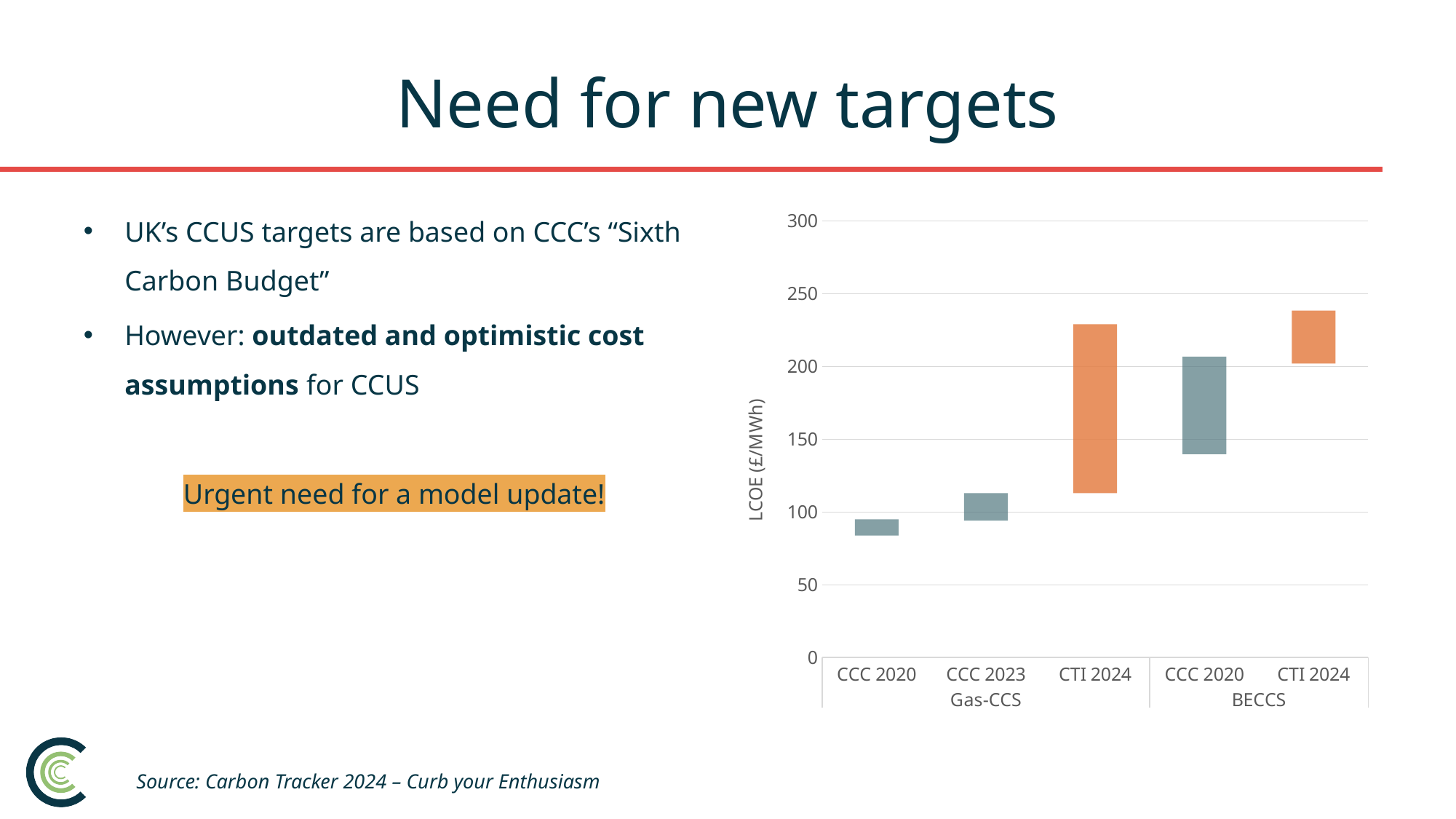
Which colour are the CTI 2024 bars in the chart? orange How many bars are plotted in the chart? 5 How many technology groups are shown on the x axis of the chart? 2 Is the upper end of the CCC 2020 Gas-CCS bar greater or less than 100? less What is the label of the y axis of the chart? LCOE (£/MWh) Is the upper end of the CTI 2024 Gas-CCS bar greater or less than 200? greater Which bar in the chart has the lowest values? CCC 2020 (Gas-CCS) Within the Gas-CCS group, do the LCOE ranges rise or fall from CCC 2020 to CTI 2024? rise What kind of chart is shown on the slide? bar chart Is the upper end of the CTI 2024 BECCS bar greater or less than 200? greater Within Gas-CCS, which bar reaches higher: CCC 2023 or CTI 2024? CTI 2024